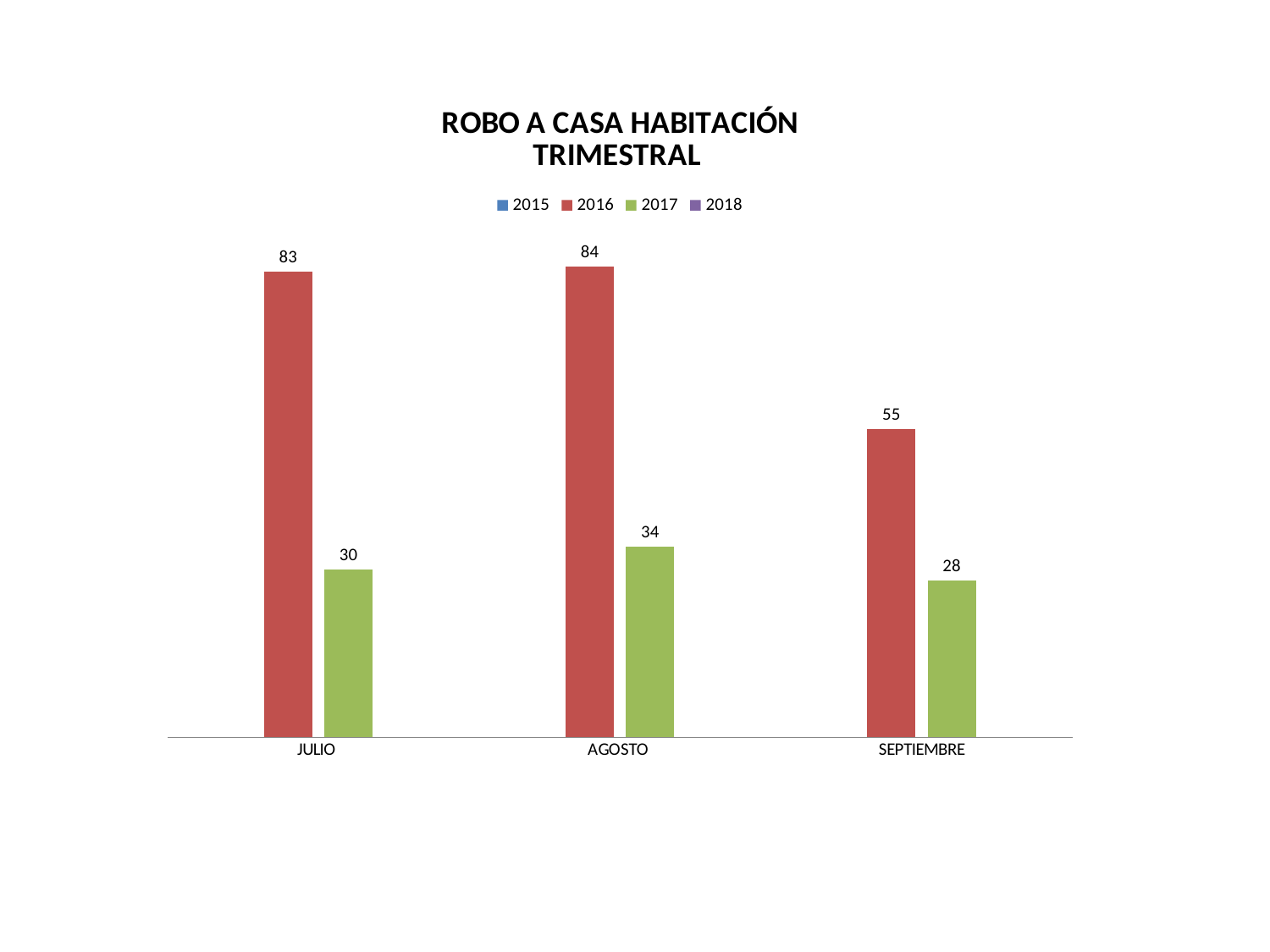
What is the value for 2016 in JULIO? 83 How many months are shown on the x axis? 3 What kind of chart is shown on the slide? Bar chart Which month has the highest value for the 2016 series? AGOSTO Which month has the lowest value for the 2017 series? SEPTIEMBRE What is the value for 2016 in SEPTIEMBRE? 55 How many series does the legend list? 4 What is the difference between the 2016 values for AGOSTO and SEPTIEMBRE? 29 Which is larger: the 2017 value in AGOSTO or the 2017 value in JULIO? AGOSTO What is the value for 2017 in AGOSTO? 34 What is the value for 2017 in SEPTIEMBRE? 28 What is the difference between the 2016 and 2017 values in JULIO? 53